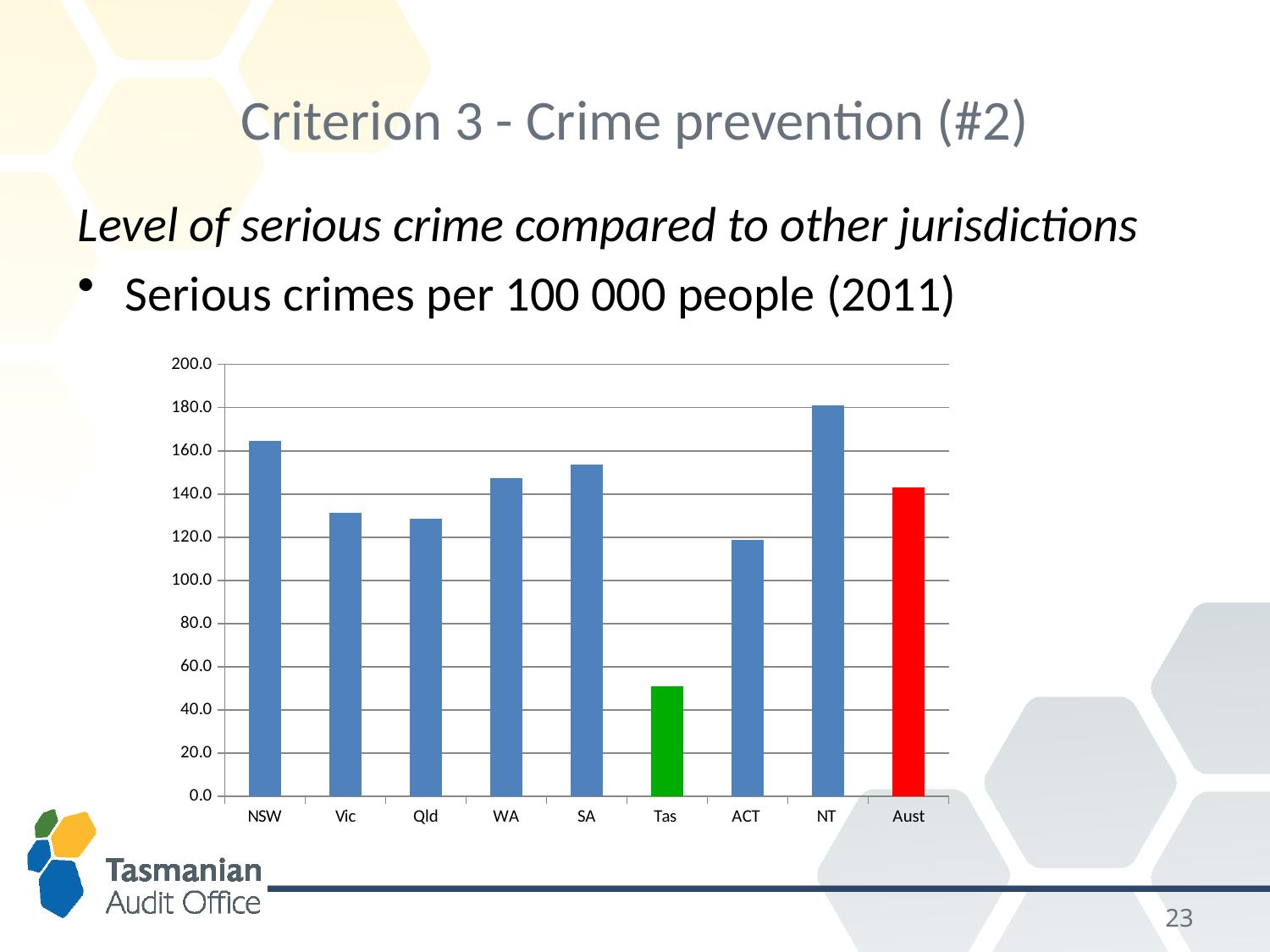
Which has a higher value, SA or WA? SA Which jurisdiction has the lowest number of serious crimes per 100 000 people? Tas Is the value for Aust greater or less than 140? greater Which jurisdiction has the highest number of serious crimes per 100 000 people? NT What kind of chart is shown on the slide? bar chart Is the value for Tas greater or less than 60? less What colour is the bar for Tas? green Which has a higher value, NSW or Vic? NSW How many jurisdictions (categories) are plotted on the x axis? 9 Is the value for NSW greater or less than 160? greater